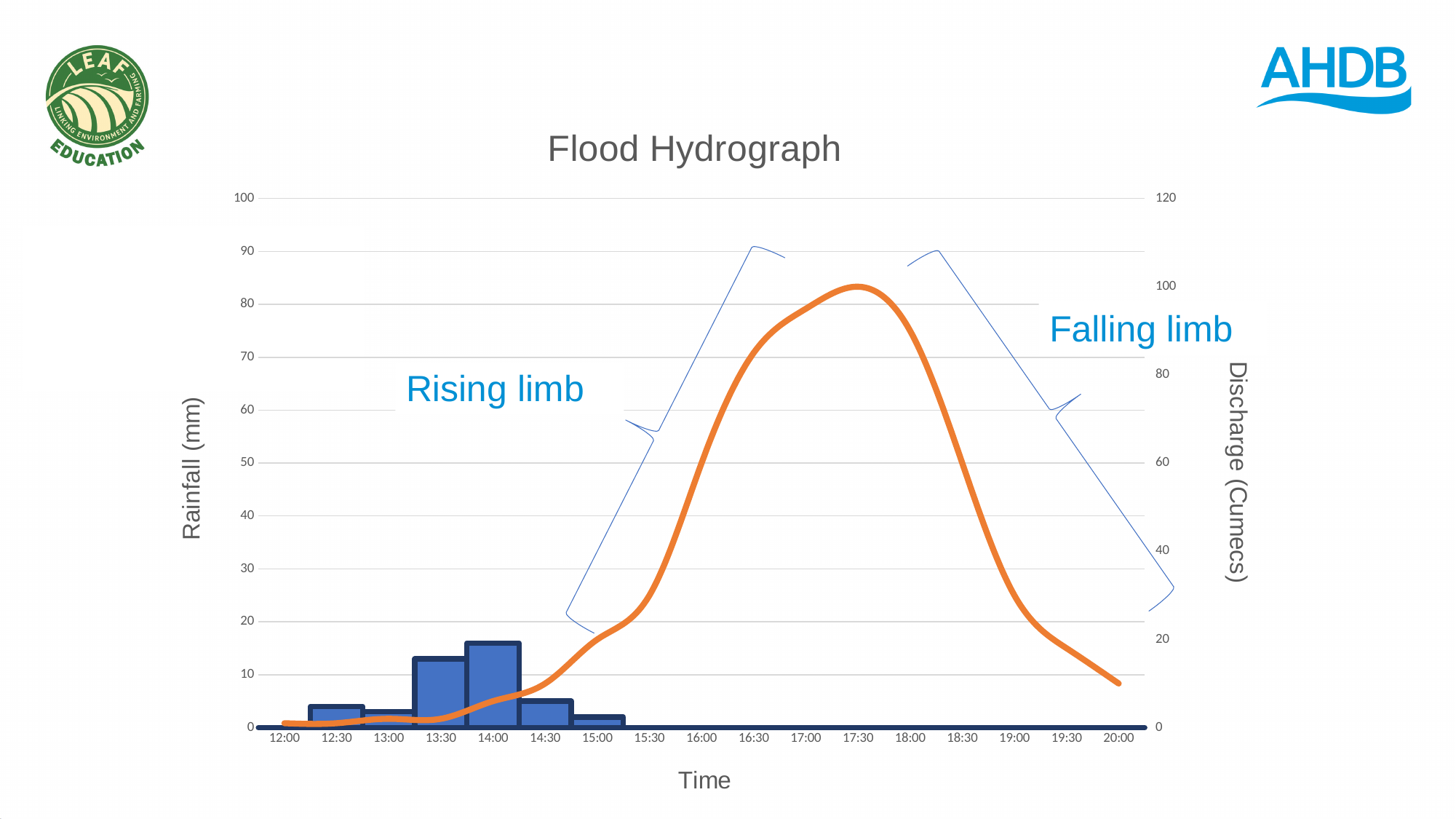
How many rainfall bars are plotted on the chart? 6 Is the rainfall at 14:00 greater or less than 10 mm? greater Is the rainfall at 12:30 greater or less than 10 mm? less At which time is the rainfall bar highest? 14:00 Is the discharge at 15:30 greater or less than 40 cumecs? less Does the discharge rise or fall between 17:30 and 20:00? fall Which has the higher rainfall, 13:30 or 14:00? 14:00 What is the title of the chart? Flood Hydrograph What kind of chart is this? Combined bar and line chart At which time does the discharge line reach its peak? 17:30